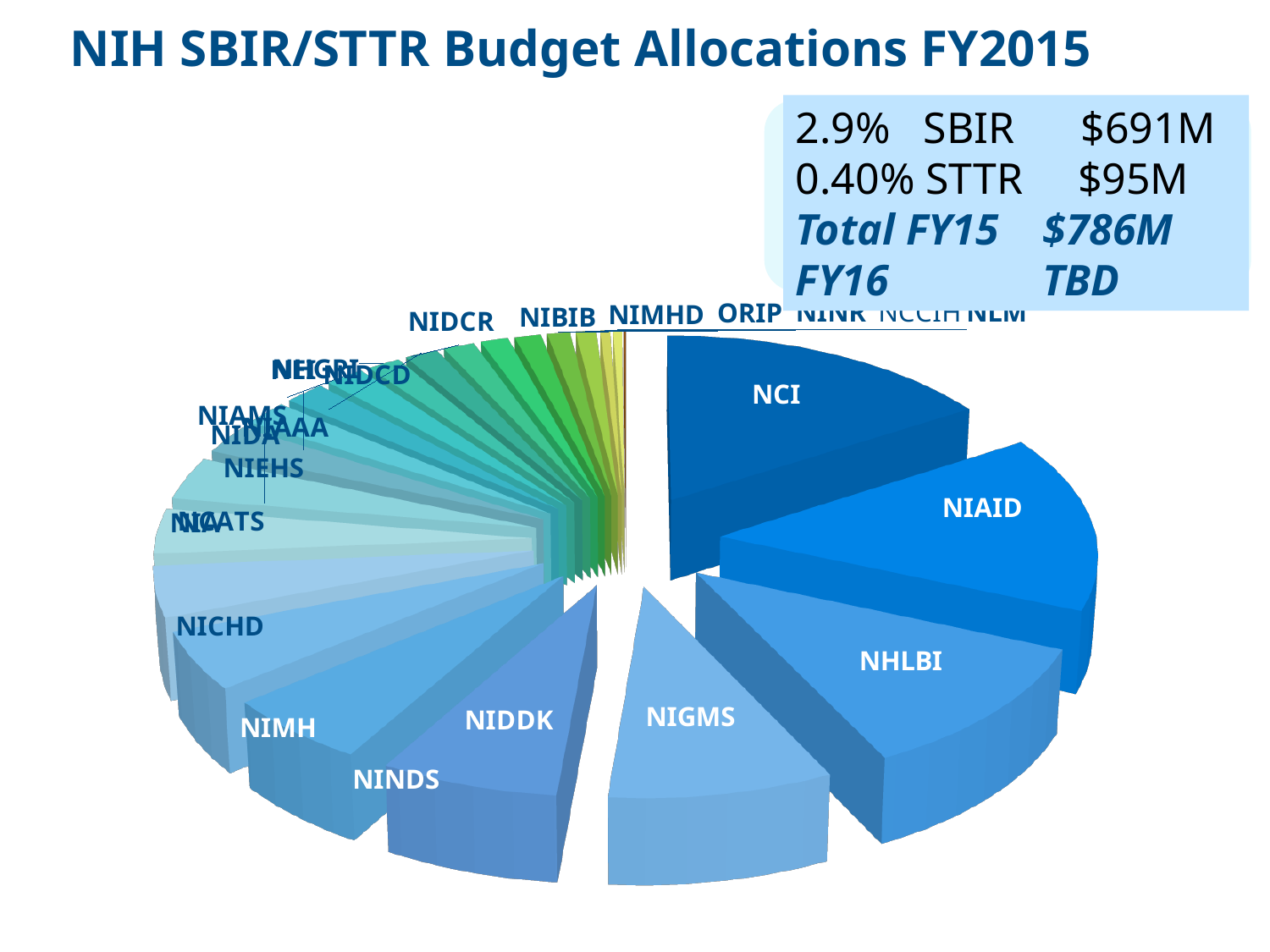
What kind of chart is shown on the slide? pie chart Which slice is larger, NIDDK or NIEHS? NIDDK What is the title of the slide containing the pie chart? NIH SBIR/STTR Budget Allocations FY2015 Which slice is larger, NHLBI or NIMH? NHLBI Which slice is larger, NIGMS or NIDCR? NIGMS According to the text box next to the chart, what is the Total FY15 amount? $786M